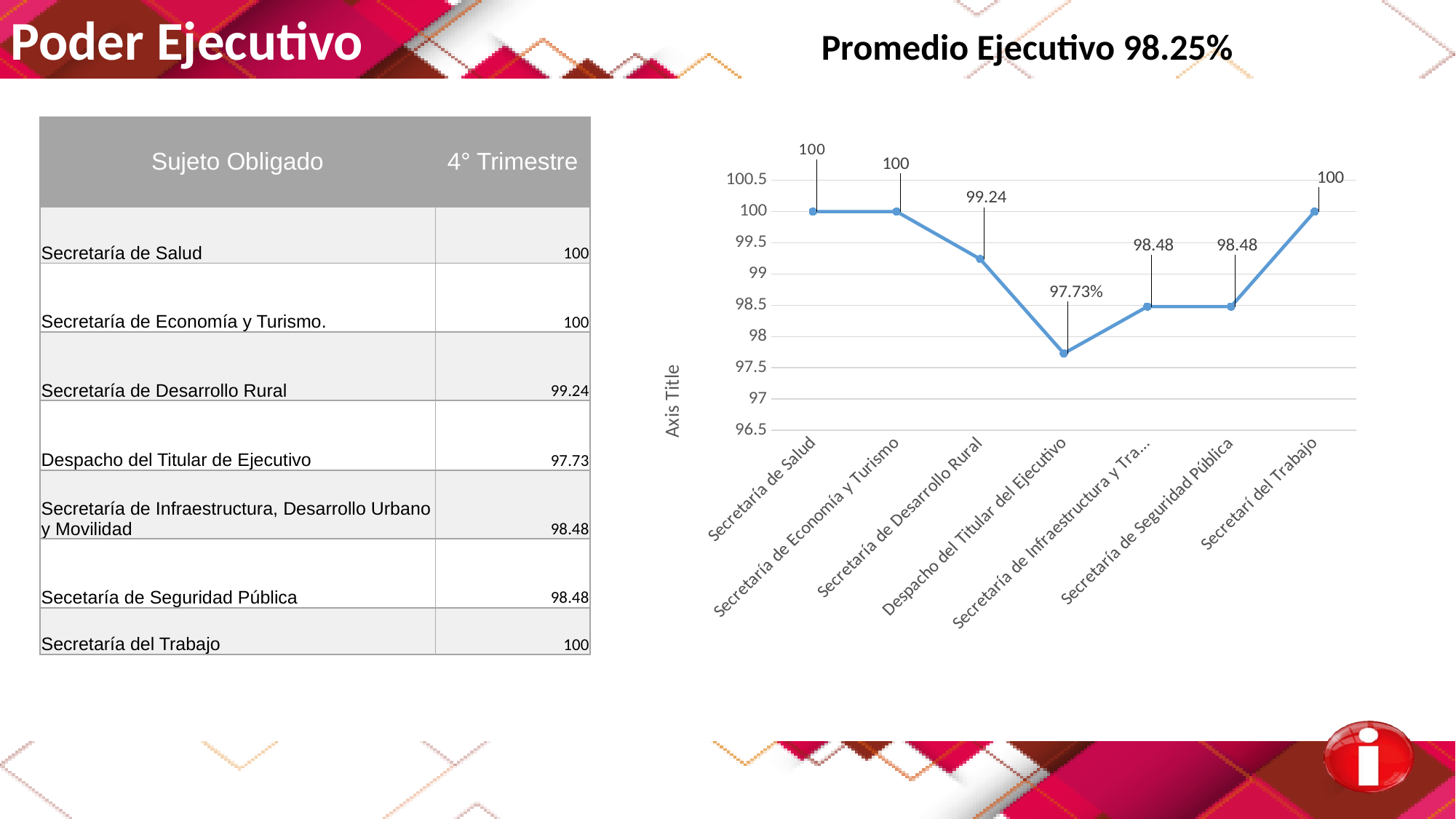
What is the value plotted for Secretaría de Desarrollo Rural? 99.24 Does the line rise or fall between Secretaría de Seguridad Pública and Secretarí del Trabajo? rise Which category has the lowest value in the chart? Despacho del Titular del Ejecutivo What is the value plotted for Secretaría de Salud? 100 What is the difference between the values for Secretaría de Desarrollo Rural and Secretaría de Seguridad Pública? 0.76 Is the value for Despacho del Titular del Ejecutivo greater or less than 98? less What is the data label shown for Despacho del Titular del Ejecutivo? 97.73% Which is larger, the value for Secretaría de Desarrollo Rural or the value for Secretaría de Infraestructura y Tra...? Secretaría de Desarrollo Rural What kind of chart is shown on the slide? line chart What is the title shown on the vertical axis of the chart? Axis Title How many categories are plotted on the x axis of the chart? 7 What is the value plotted for Secretaría de Seguridad Pública? 98.48